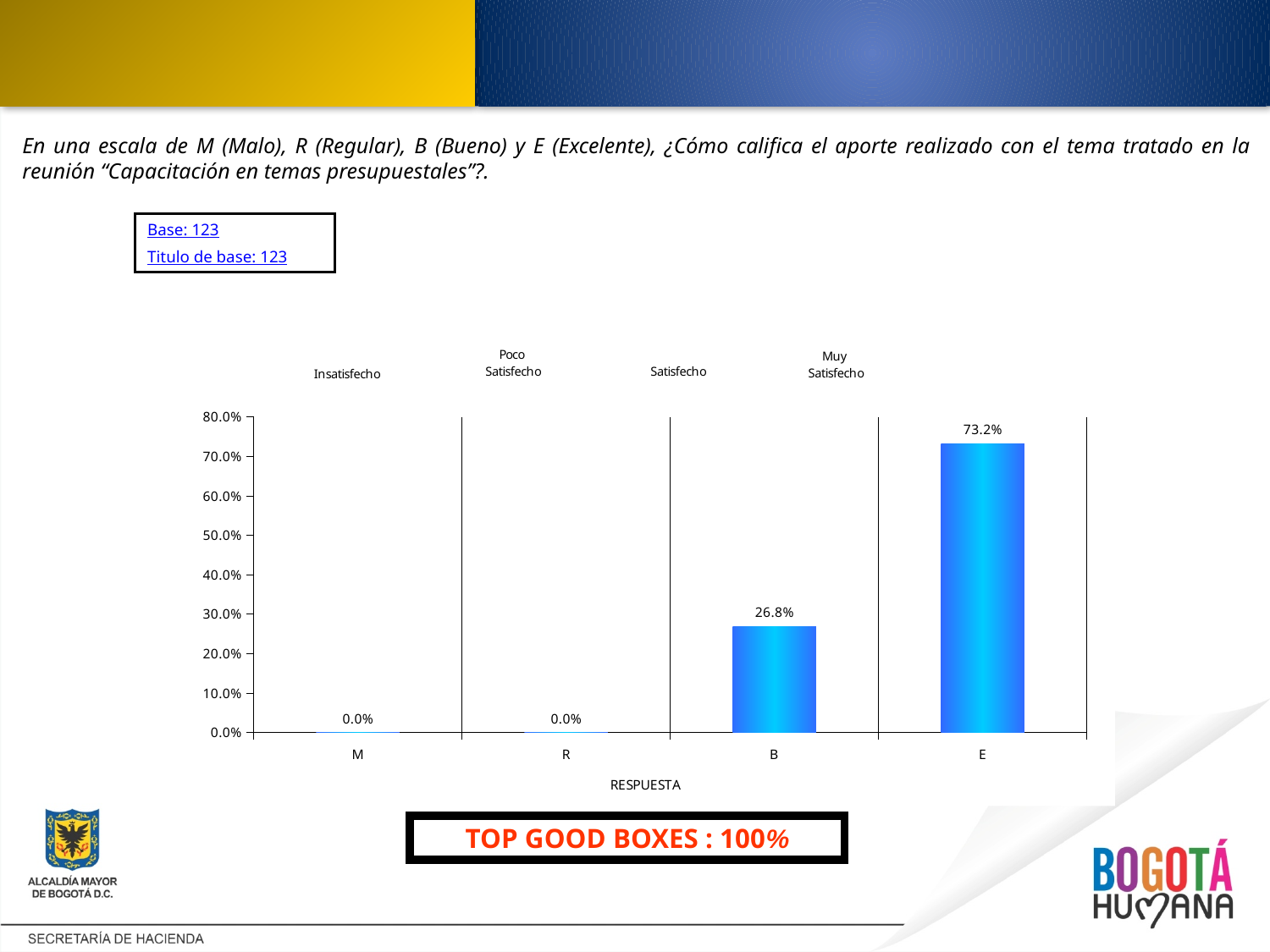
What is the difference between the values for E and B? 46.4% What is the label of the x axis? RESPUESTA What is the value for category M? 0.0% What is the value for category B? 26.8% How many categories are shown on the x axis? 4 What is the value for category E? 73.2% What is the value for category R? 0.0% Is the value for E greater or less than 70.0%? greater Which is larger, the value for B or the value for E? E What is the total of the values for B and E? 100.0% Which category has the highest value? E What kind of chart is shown on the slide? bar chart